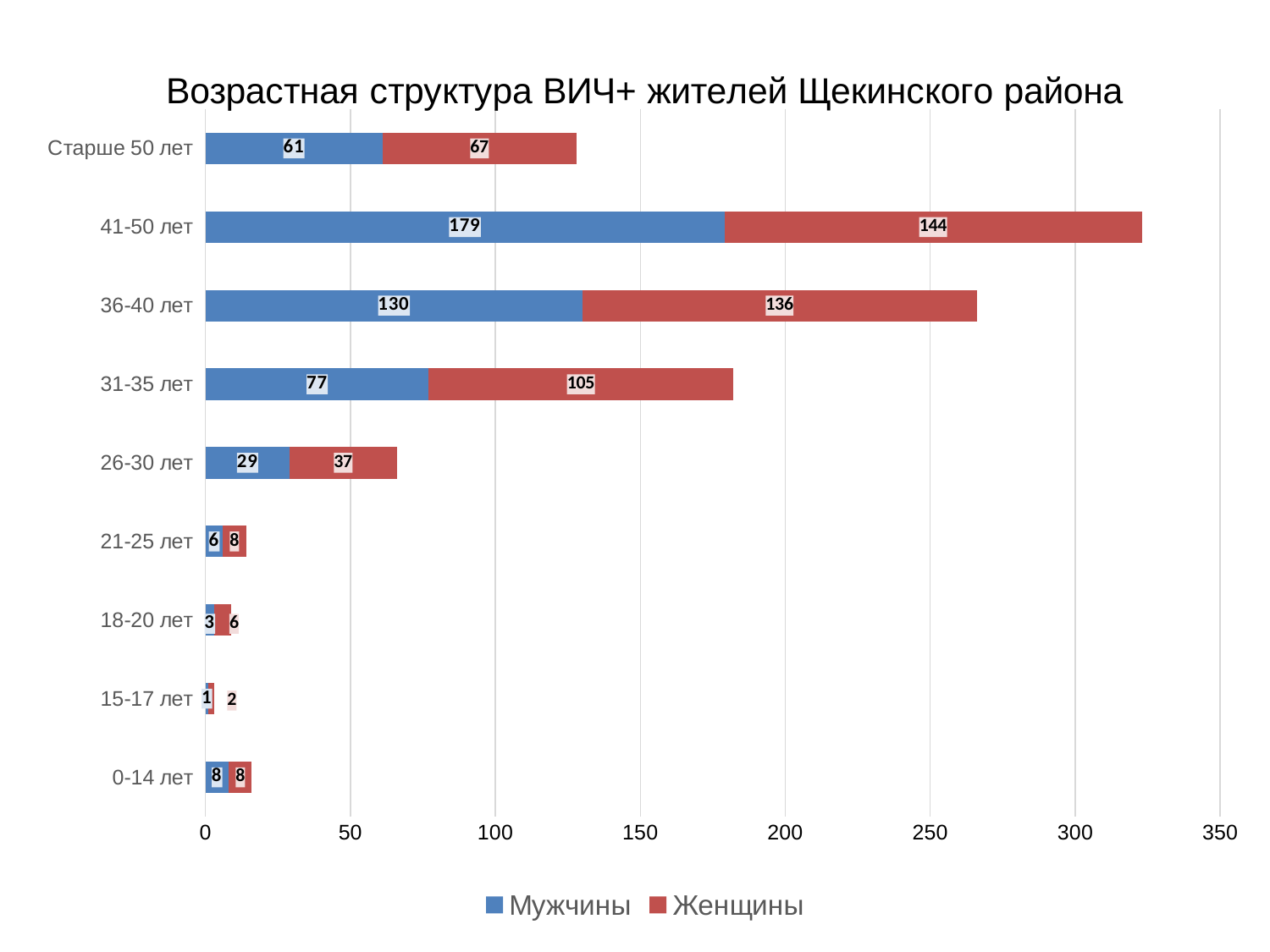
How many series does the legend list? 2 What is the difference between Женщины and Мужчины in the 36-40 лет category? 6 What is the total of the stacked bar for 26-30 лет? 66 How many age categories are shown on the chart? 9 What kind of chart is shown on the slide? Stacked bar chart What is the total of the stacked bar for 41-50 лет? 323 What is the value for Мужчины in the 41-50 лет category? 179 Which age category has the highest value for Мужчины? 41-50 лет Which is larger in the Старше 50 лет category, Мужчины or Женщины? Женщины What is the title of the chart? Возрастная структура ВИЧ+ жителей Щекинского района Which age category has the lowest value for Женщины? 15-17 лет What is the value for Женщины in the 31-35 лет category? 105